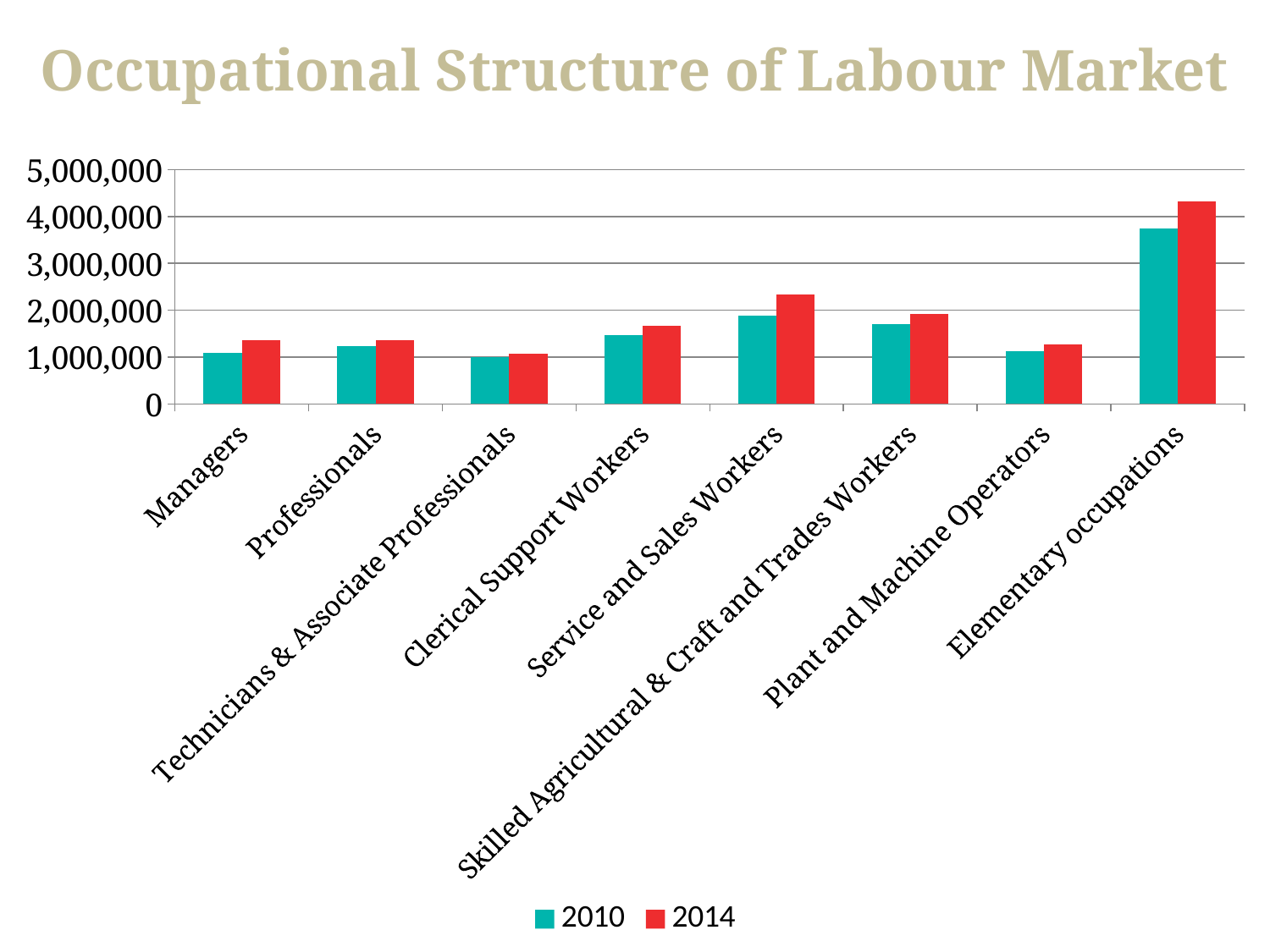
For 2010, which is larger: Clerical Support Workers or Managers? Clerical Support Workers Is the 2010 value for Elementary occupations greater or less than 4,000,000? less Which occupational category has the lowest value for 2014? Technicians & Associate Professionals Is the 2014 value for Elementary occupations greater or less than 4,000,000? greater Is the 2010 value for Skilled Agricultural & Craft and Trades Workers greater or less than 2,000,000? less Which occupational category has the highest value for 2014? Elementary occupations For 2014, which is larger: Service and Sales Workers or Skilled Agricultural & Craft and Trades Workers? Service and Sales Workers What kind of chart is shown on the slide? Bar chart How many series does the legend list? 2 What is the title of the chart? Occupational Structure of Labour Market How many occupational categories are shown on the x axis? 8